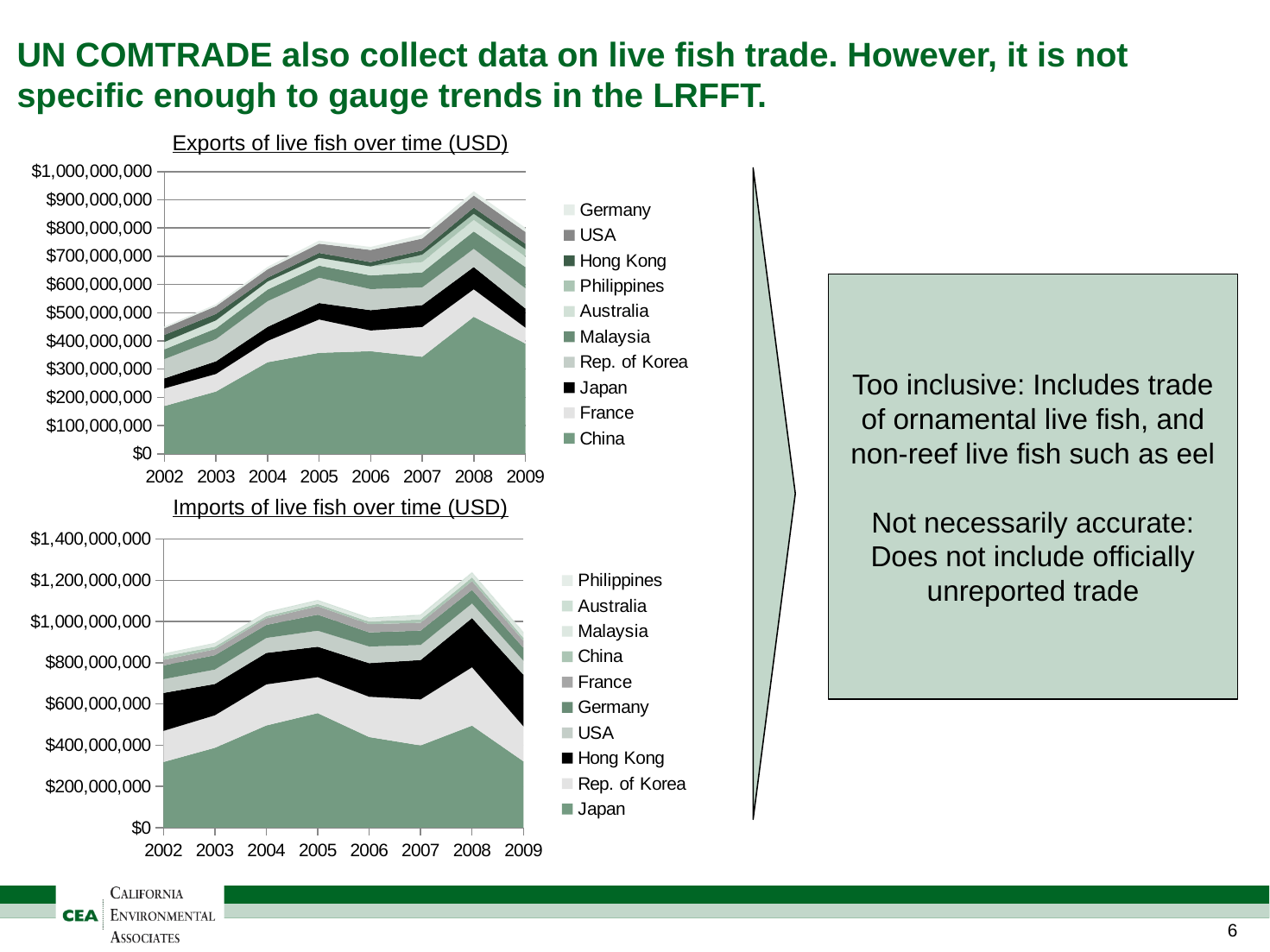
In the 'Exports of live fish over time (USD)' chart, which year has the lowest total exports? 2002 In the 'Exports of live fish over time (USD)' chart, which year has the highest total exports? 2008 In the 'Imports of live fish over time (USD)' chart, is the total for 2002 greater or less than $1,000,000,000? less In the 'Exports of live fish over time (USD)' chart, do total exports generally rise or fall from 2002 to 2008? rise Which series is plotted at the bottom of the stack in the 'Imports of live fish over time (USD)' chart? Japan What kind of chart is the 'Exports of live fish over time (USD)' chart? Stacked area chart How many series does the legend of the 'Exports of live fish over time (USD)' chart list? 10 How many years are shown on the x axis of the 'Exports of live fish over time (USD)' chart? 8 In the 'Imports of live fish over time (USD)' chart, which year has the highest total imports? 2008 In the 'Imports of live fish over time (USD)' chart, is the total for 2008 greater or less than $1,000,000,000? greater In the 'Exports of live fish over time (USD)' chart, is the total for 2008 greater or less than $800,000,000? greater How many series does the legend of the 'Imports of live fish over time (USD)' chart list? 10